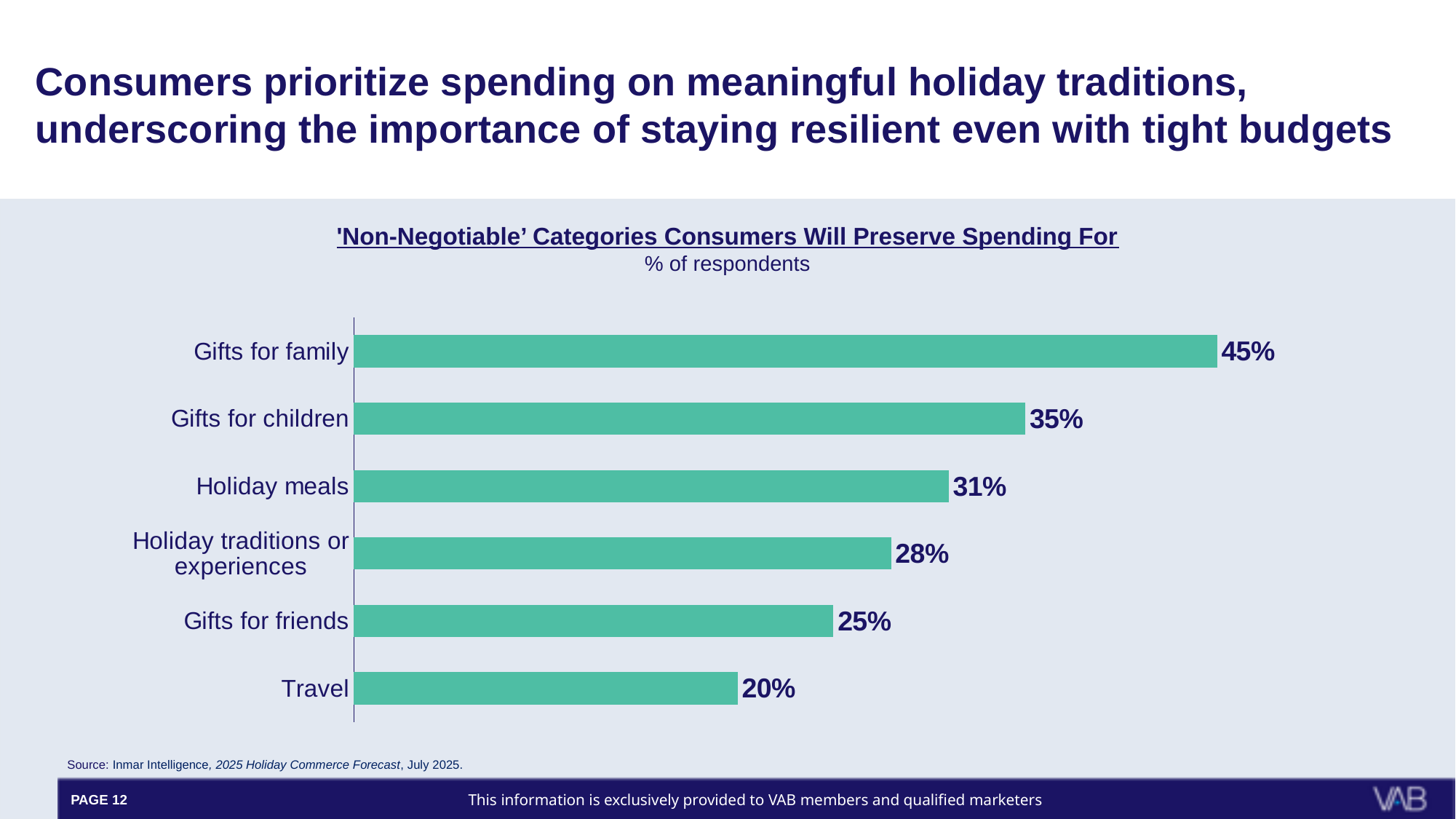
What is the difference in percentage points between Gifts for friends and Travel? 5 percentage points What is the title of the chart? 'Non-Negotiable' Categories Consumers Will Preserve Spending For What is the difference in percentage points between Gifts for family and Gifts for children? 10 percentage points What is the value shown for Travel? 20% How many categories are shown in the chart? 6 Which is larger, the value for Holiday meals or the value for Gifts for friends? Holiday meals Which category has the highest share of respondents? Gifts for family Which category has the lowest share of respondents? Travel What type of chart is shown on the slide? Bar chart What is the value shown for Holiday traditions or experiences? 28% What percentage of respondents said gifts for family is a non-negotiable category? 45% What is the value shown for Holiday meals? 31%